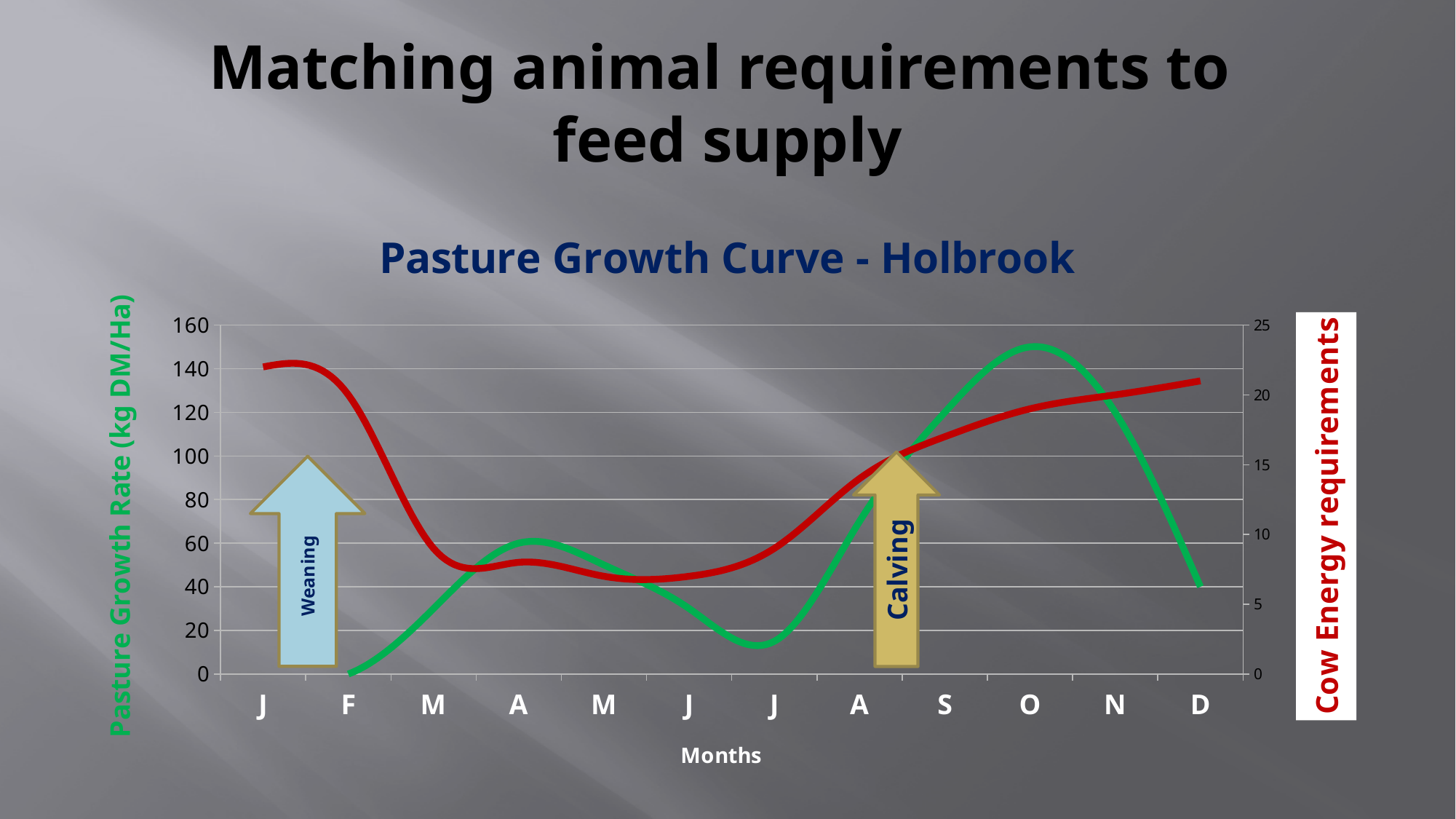
Which is larger: the Pasture Growth Rate in month O or in month A? O Does the green Pasture Growth Rate line rise or fall from month J (July) to month O? rise How many months are shown along the x axis of the chart? 12 Is the Pasture Growth Rate value in month O greater or less than 140? greater In which month is the green Pasture Growth Rate line at its lowest value? F What does the left vertical axis of the chart measure? Pasture Growth Rate (kg DM/Ha) What kind of chart is shown on the slide? line chart Is the Pasture Growth Rate value in the second J month (July) greater or less than 20? less What is the title of the chart? Pasture Growth Curve - Holbrook Is the Cow Energy requirements value in month J (January) greater or less than 20 on the right axis? greater In which month does the green Pasture Growth Rate line reach its highest value? O